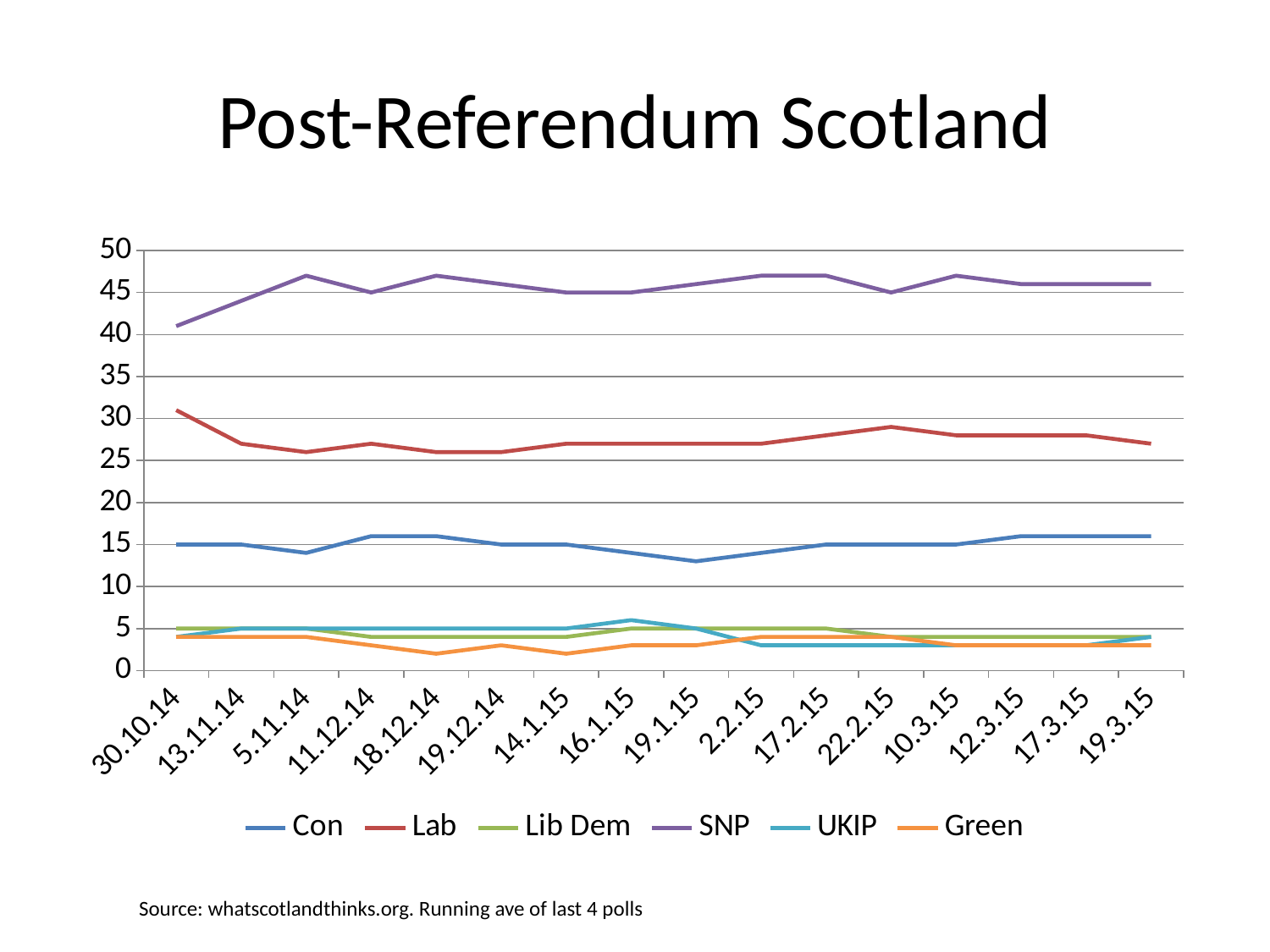
Is the value for Lab on 30.10.14 greater or less than 25? greater Does the SNP line rise or fall between 30.10.14 and 5.11.14? rise What is the value for Con on 30.10.14? 15 What is the value for SNP on 11.12.14? 45 How many series does the legend list? 6 What kind of chart is shown on the slide? line chart How many dates are shown along the x axis? 16 Which party has the highest values across the whole chart? SNP Which is larger on 17.2.15, the value for Lab or the value for Con? Lab Is the value for Con on 19.1.15 greater or less than 15? less Is the value for SNP on 30.10.14 greater or less than 40? greater What is the title of the chart? Post-Referendum Scotland